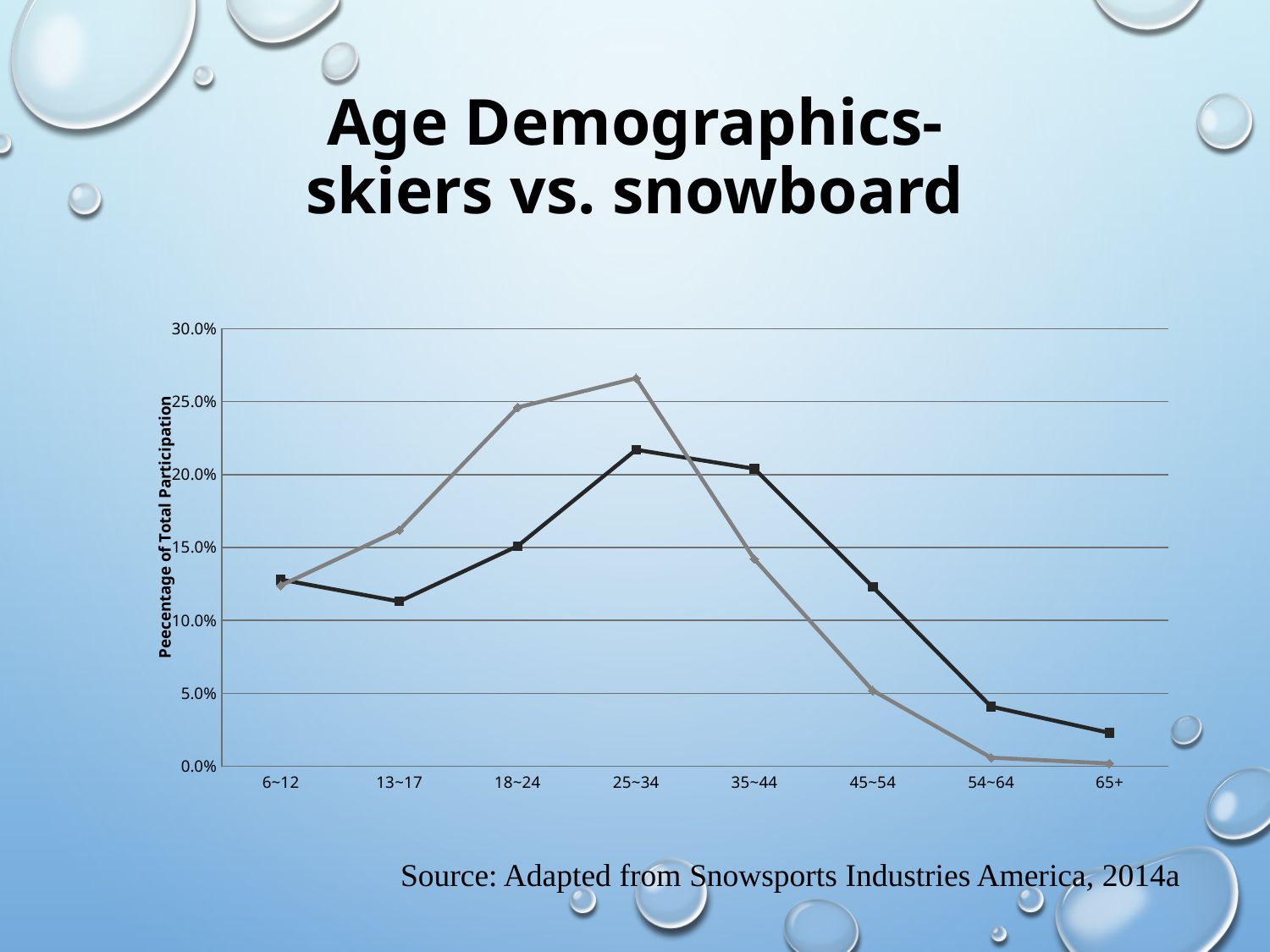
Which age category has the lowest value on the gray line? 65+ How many lines are plotted on the chart? 2 How many age categories are shown on the x axis? 8 Do the values of the gray line rise or fall from 25~34 to 65+? fall Which age category has the highest value on the black line? 25~34 Which age category has the highest value on the gray line? 25~34 Is the value of the gray line for 25~34 greater or less than 25.0%? greater What kind of chart is shown on the slide? line chart Is the value of the black line for 65+ greater or less than 5.0%? less At 18~24, which line has the higher value, the black line or the gray line? gray line At 45~54, which line has the higher value, the black line or the gray line? black line